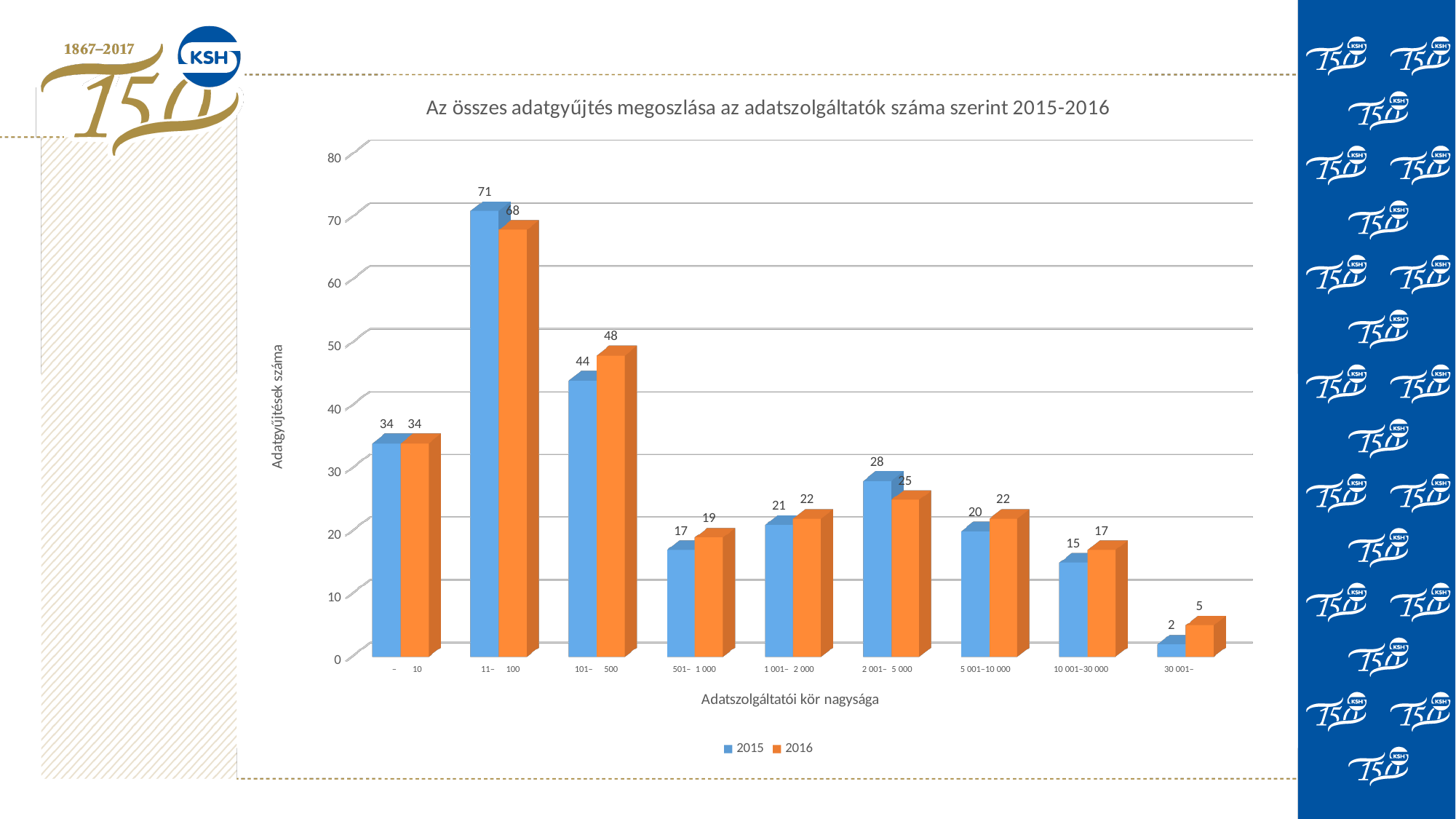
Which category has the lowest 2016 value? 30 001– How many series does the legend list? 2 How many categories are shown on the x axis? 9 What is the 2016 value for the 101–500 category? 48 What is the difference between the 2015 and 2016 values for the 2 001–5 000 category? 3 What kind of chart is shown on the slide? bar chart Which category has the highest 2015 value? 11–100 What is the label of the y axis? Adatgyűjtések száma Which is larger for the 101–500 category, the 2015 value or the 2016 value? 2016 What is the title of the chart? Az összes adatgyűjtés megoszlása az adatszolgáltatók száma szerint 2015-2016 What is the 2015 value for the 11–100 category? 71 What is the 2016 value for the 30 001– category? 5